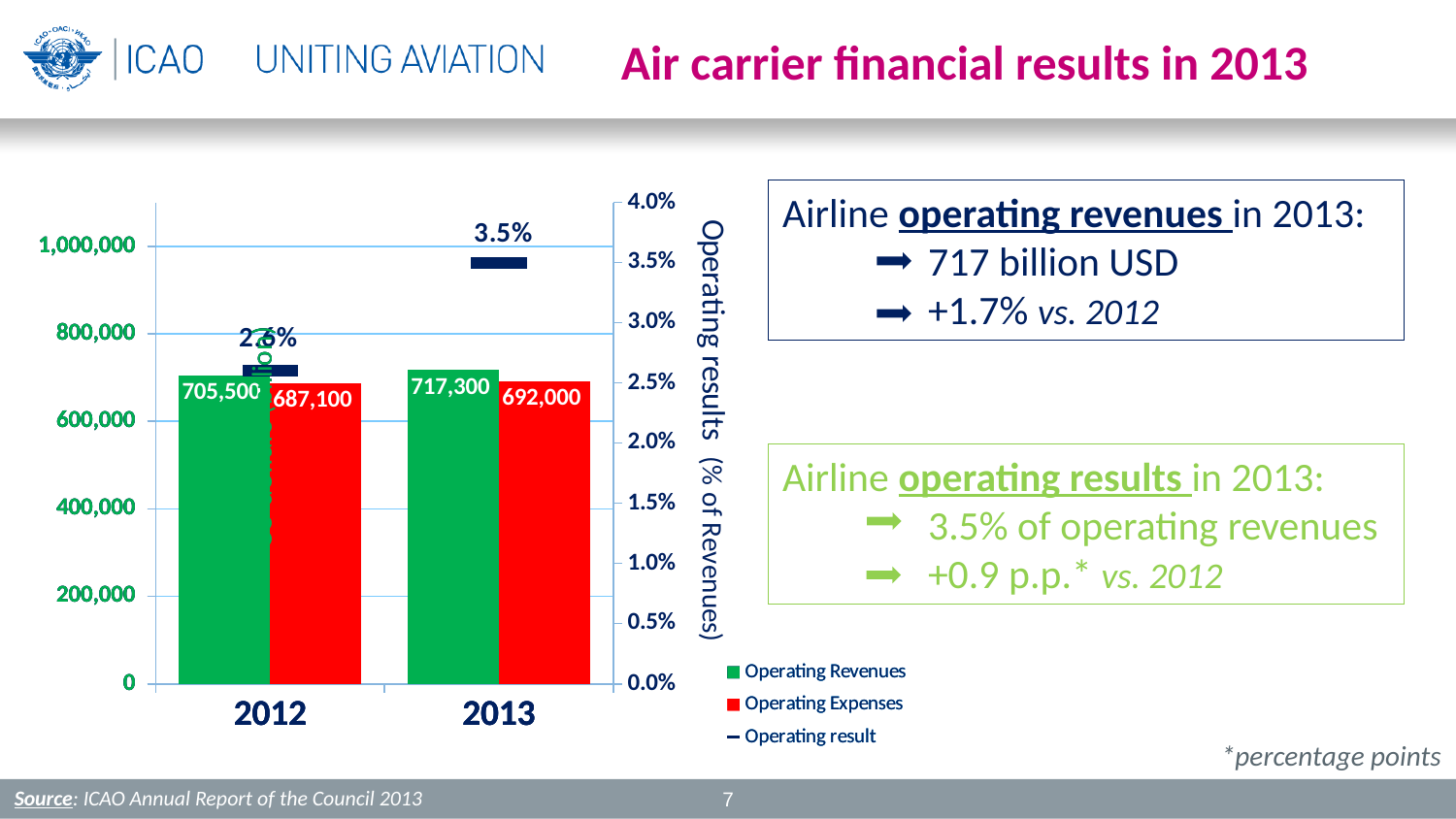
How many series does the legend list? 3 Which year has the higher Operating Expenses, 2012 or 2013? 2013 What is the value of Operating Revenues for 2012? 705,500 How many years are shown on the x axis? 2 Is the Operating result for 2012 greater or less than 3.0%? less What is the difference between Operating Revenues and Operating Expenses in 2013? 25,300 What is the Operating result for 2013, as a percentage of revenues? 3.5% Which colour represents Operating Expenses in the legend? red By how much did Operating Revenues increase from 2012 to 2013? 11,800 What kind of chart is used to show Operating Revenues and Operating Expenses? bar chart What is the value of Operating Revenues for 2013? 717,300 What is the value of Operating Expenses for 2012? 687,100